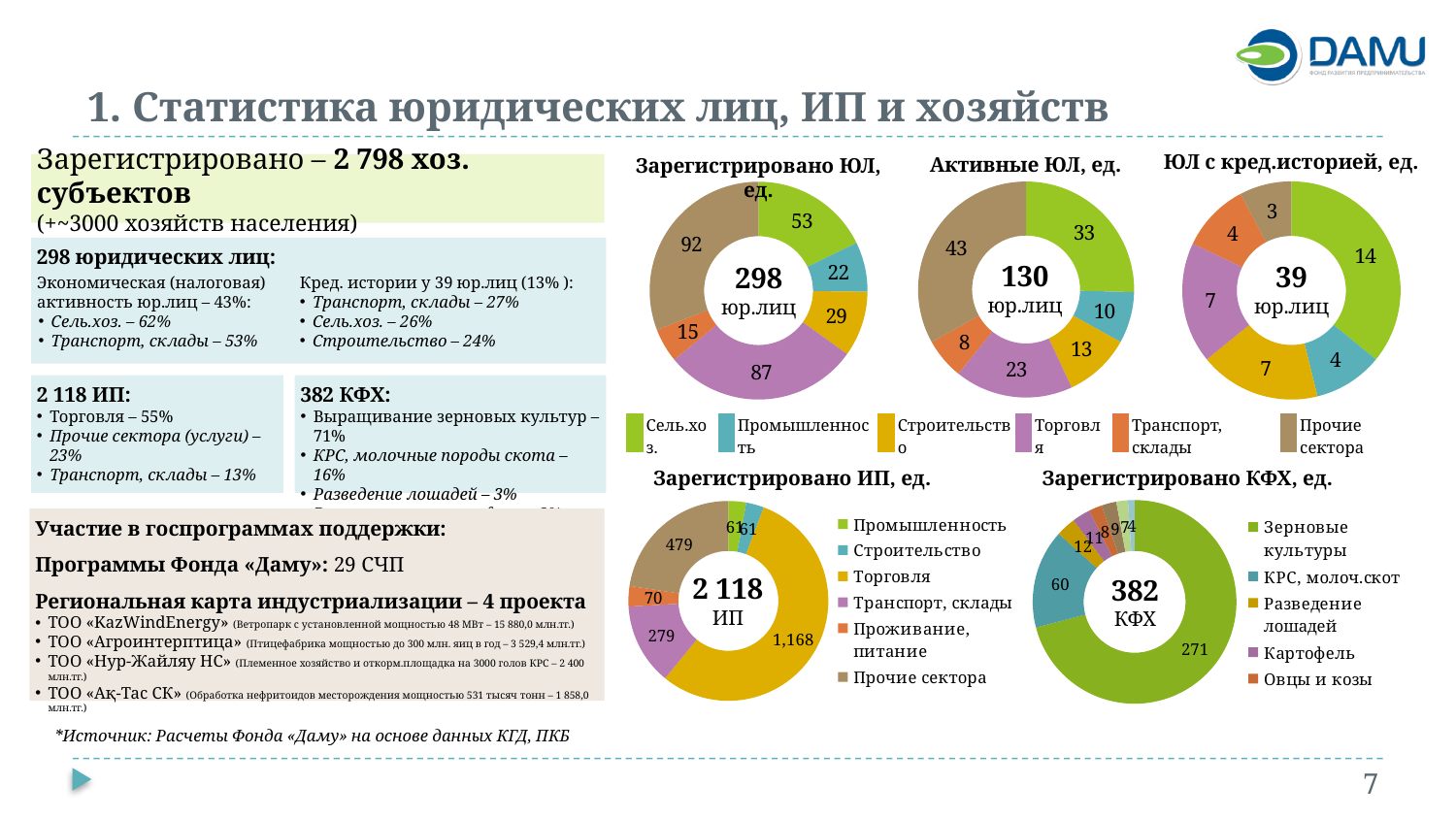
In the chart titled "Зарегистрировано ЮЛ, ед.", which sector has the highest value? Прочие сектора In the chart titled "Зарегистрировано КФХ, ед.", what is the value for Зерновые культуры? 271 In the chart titled "Активные ЮЛ, ед.", what is the difference between Прочие сектора and Торговля? 20 What type of chart is used for "Зарегистрировано ИП, ед."? Donut (pie) chart In the chart titled "Зарегистрировано ИП, ед.", which is larger: Транспорт, склады or Прочие сектора? Прочие сектора In the chart titled "Зарегистрировано КФХ, ед.", how many entries does the legend list? 5 In the chart titled "ЮЛ с кред.историей, ед.", what total number is shown in the centre of the donut? 39 юр.лиц In the chart titled "Зарегистрировано ЮЛ, ед.", what is the value for Торговля? 87 In the chart titled "Зарегистрировано ЮЛ, ед.", which sector has the lowest value? Транспорт, склады In the chart titled "ЮЛ с кред.историей, ед.", what is the value for Сель.хоз.? 14 In the chart titled "Активные ЮЛ, ед.", what is the value for Сель.хоз.? 33 In the chart titled "Зарегистрировано ИП, ед.", what is the value for Торговля? 1,168